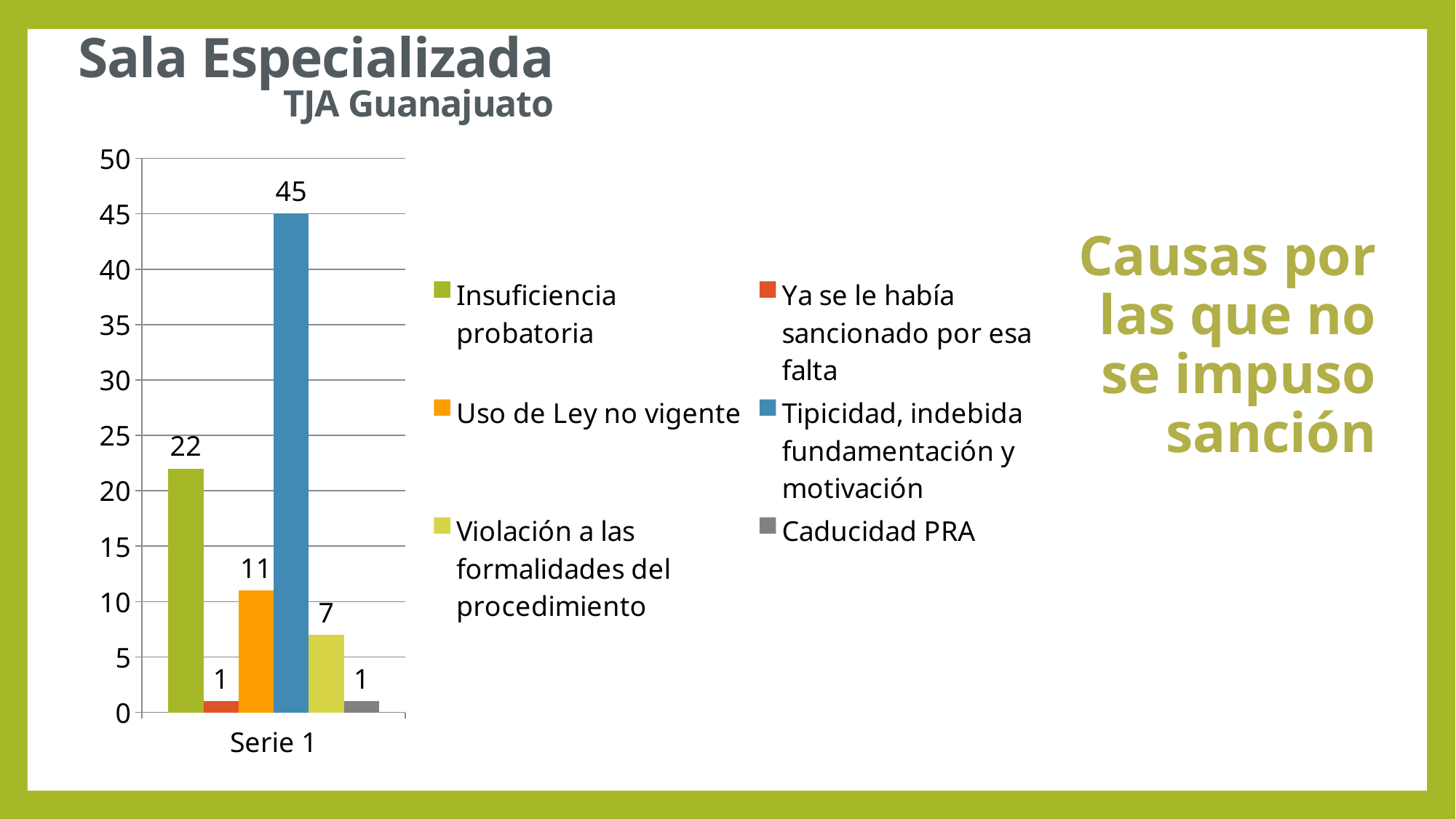
What value is shown for Violación a las formalidades del procedimiento? 7 What value is shown for Tipicidad, indebida fundamentación y motivación? 45 Which is larger, the value for Uso de Ley no vigente or the value for Violación a las formalidades del procedimiento? Uso de Ley no vigente What value is shown for Caducidad PRA? 1 How many series does the legend list? 6 Which legend entry has the highest value? Tipicidad, indebida fundamentación y motivación What is the difference between the values for Tipicidad, indebida fundamentación y motivación and Insuficiencia probatoria? 23 What value is shown for Insuficiencia probatoria? 22 What value is shown for Uso de Ley no vigente? 11 What is the label on the x axis under the bars? Serie 1 What kind of chart is shown on the slide? bar chart Is the value for Insuficiencia probatoria greater or less than 25? less